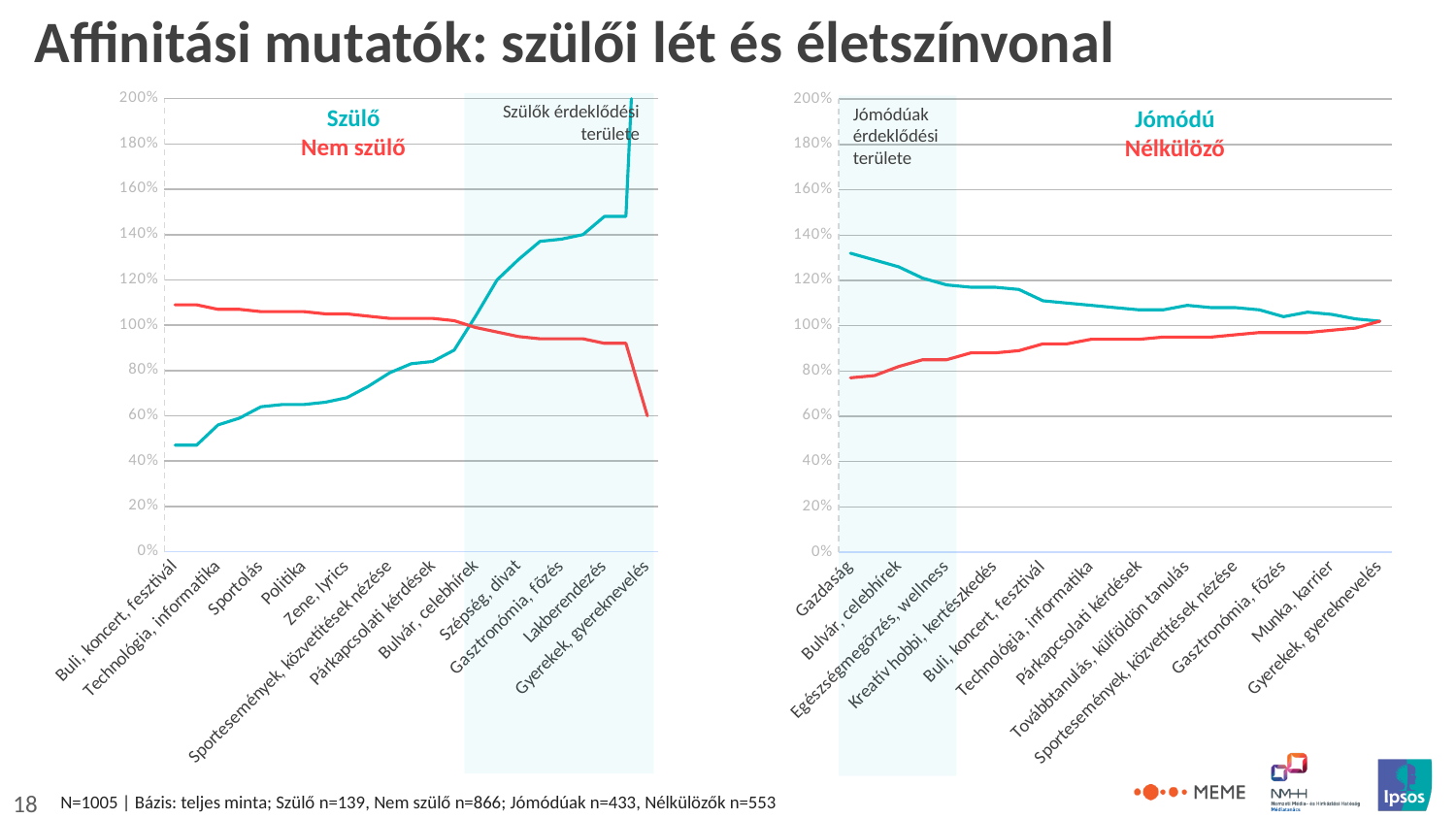
On the left chart, which series has the larger value for 'Buli, koncert, fesztivál', Szülő or Nem szülő? Nem szülő On the left chart, does the Szülő line rise or fall from left to right along the x axis? rise On the left chart, is the Nem szülő value for 'Buli, koncert, fesztivál' greater or less than 100%? greater On the left chart, is the Szülő value for 'Buli, koncert, fesztivál' greater or less than 60%? less On the left chart, is the Szülő value for 'Gyerekek, gyereknevelés' greater or less than 180%? greater How many series are plotted on the right chart (Jómódú / Nélkülöző)? 2 On the left chart, what colour is the Nem szülő line? red On the right chart, which series has the larger value for 'Gazdaság', Jómódú or Nélkülöző? Jómódú What kind of chart is the left chart (Szülő / Nem szülő)? line chart